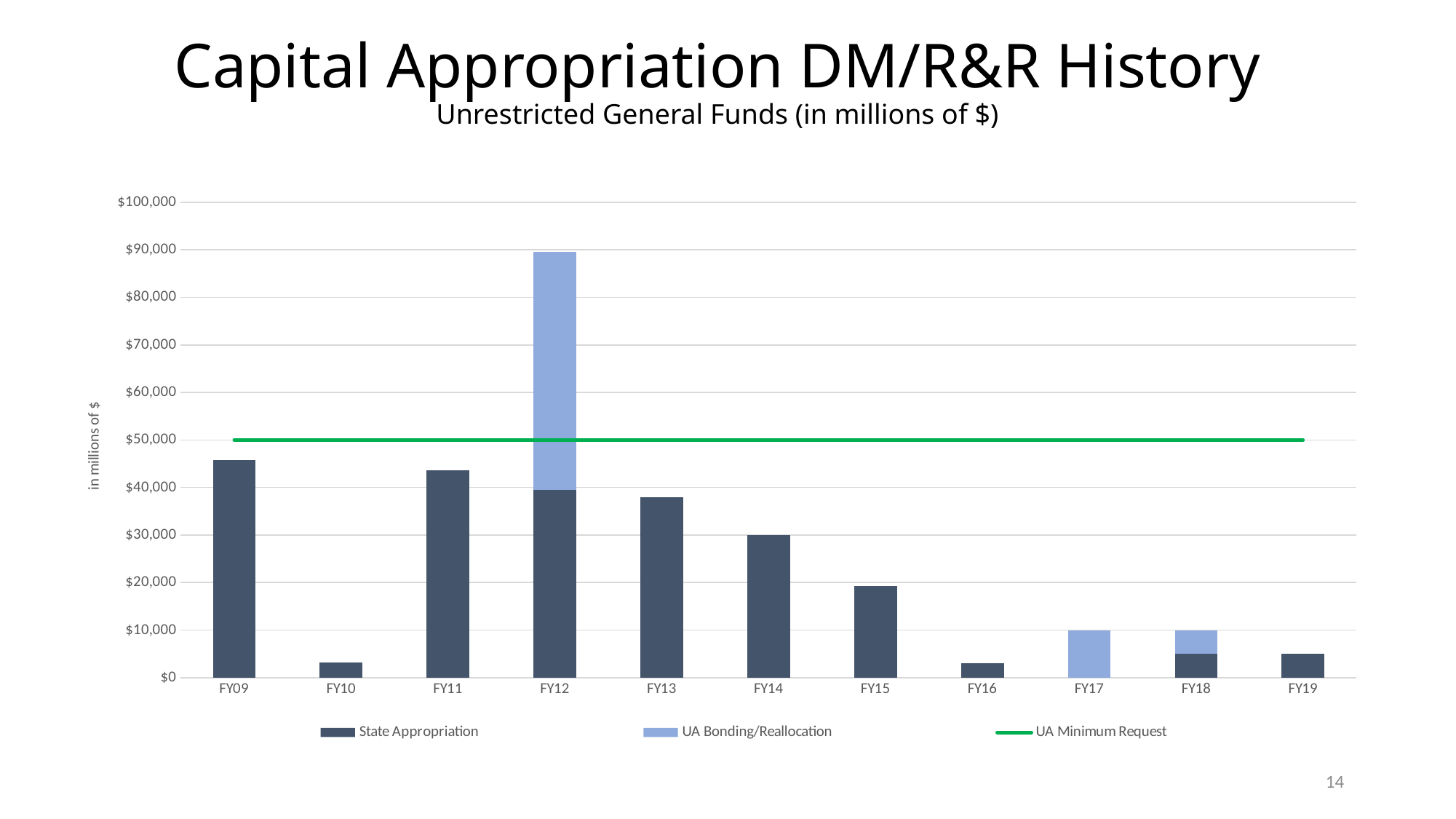
Is the State Appropriation value for FY13 greater or less than $40,000? less How many fiscal years are shown on the x axis? 11 Is the total bar for FY12 greater or less than $80,000? greater At what value does the UA Minimum Request line sit? $50,000 Which fiscal year has the tallest total bar? FY12 Do the State Appropriation values rise or fall from FY13 to FY16? fall Is the State Appropriation value for FY15 greater or less than $20,000? less How many series does the legend list? 3 Which is larger, the State Appropriation for FY13 or for FY14? FY13 Which legend entry is shown as a green line? UA Minimum Request What kind of chart is shown on the slide? combination bar and line chart